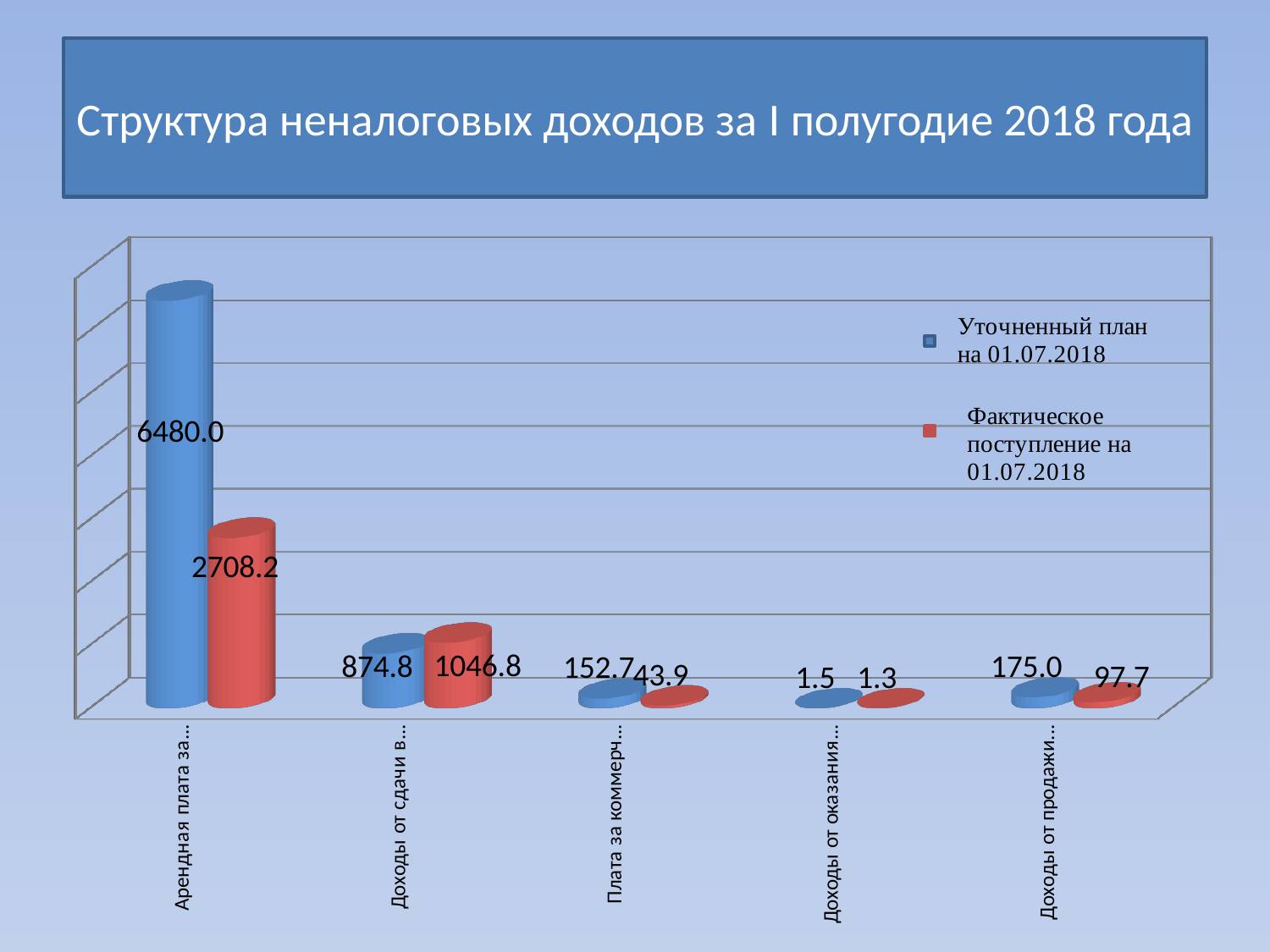
For the category 'Доходы от сдачи в...', which is larger: 'Уточненный план на 01.07.2018' or 'Фактическое поступление на 01.07.2018'? Фактическое поступление на 01.07.2018 How many series does the chart legend list? 2 How many categories are shown on the x axis of the chart? 5 What is the value of 'Фактическое поступление на 01.07.2018' for the category 'Доходы от сдачи в...'? 1046.8 What is the value of 'Фактическое поступление на 01.07.2018' for the category 'Доходы от продажи...'? 97.7 What type of chart is shown on the slide? Bar chart What is the value of 'Фактическое поступление на 01.07.2018' for the category 'Арендная плата за...'? 2708.2 Which category has the highest value for 'Уточненный план на 01.07.2018'? Арендная плата за... Which category has the lowest value for 'Фактическое поступление на 01.07.2018'? Доходы от оказания... What is the value of 'Уточненный план на 01.07.2018' for the category 'Плата за коммерч...'? 152.7 What is the difference between 'Уточненный план на 01.07.2018' and 'Фактическое поступление на 01.07.2018' for the category 'Арендная плата за...'? 3771.8 What is the value of 'Уточненный план на 01.07.2018' for the category 'Арендная плата за...'? 6480.0